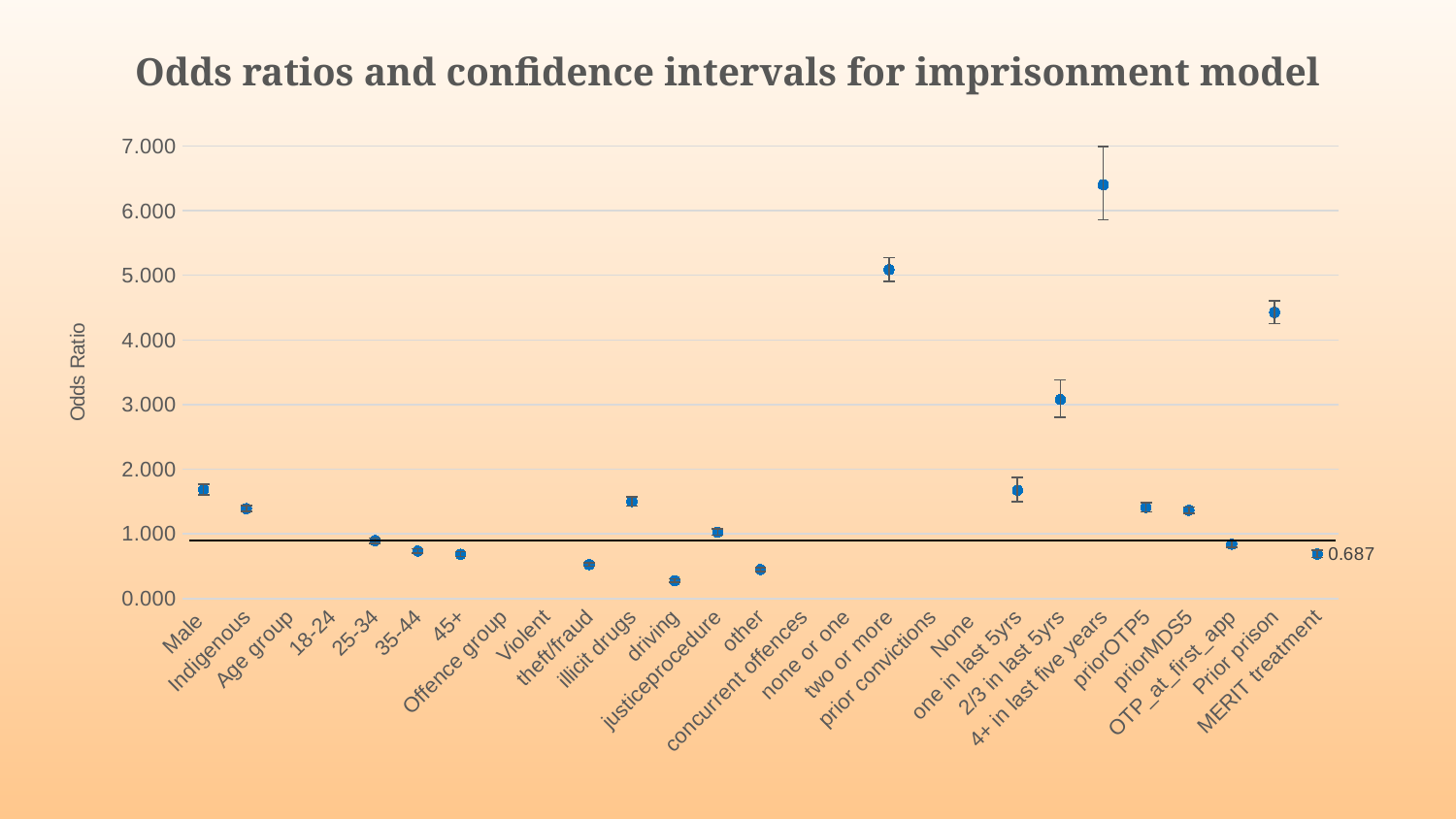
What is the odds ratio value labelled for MERIT treatment? 0.687 Is the odds ratio for Male greater or less than 2.000? less Is the odds ratio for Prior prison greater or less than 4.000? greater Which has the larger odds ratio, 'two or more' or Prior prison? two or more What is the label on the vertical axis of the chart? Odds Ratio Which category has the lowest odds ratio? driving Is the odds ratio for 'two or more' greater or less than 4.000? greater Which category has the highest odds ratio? 4+ in last five years Which has the larger odds ratio, '4+ in last five years' or 'two or more'? 4+ in last five years What type of chart is shown on the slide? Scatter chart with error bars